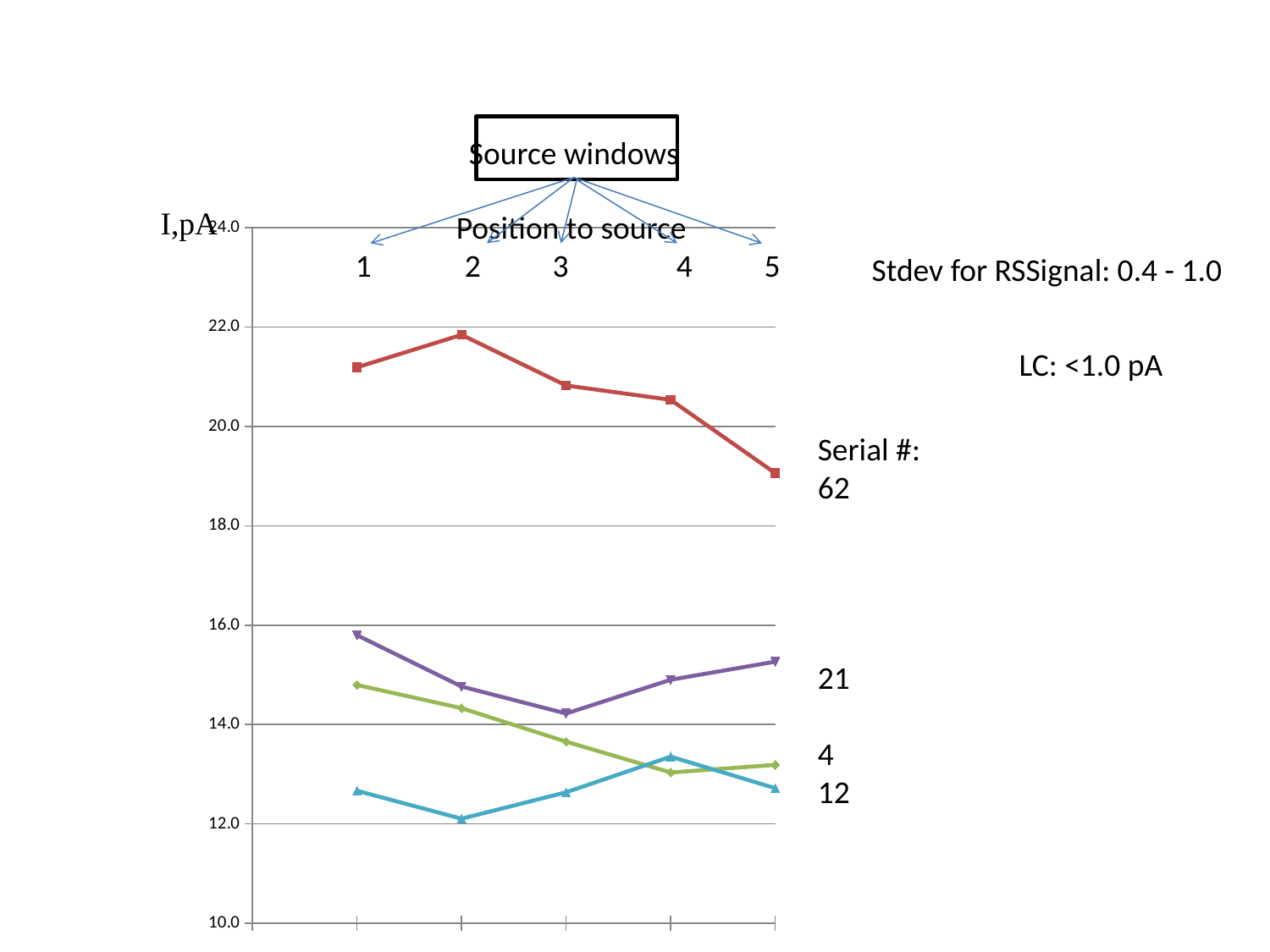
Is the value for serial # 21 at position 1 greater or less than 14.0? greater How many serial-number lines are plotted on the chart? 4 Is the value for serial # 12 at position 2 greater or less than 14.0? less Is the value for serial # 62 at position 2 greater or less than 20.0? greater Which serial # has the lowest value at position 2? 12 What kind of chart is shown on the slide? line chart Which serial # has the highest value at position 3? 62 Does the line for serial # 4 rise or fall from position 1 to position 4? fall How many positions to source are plotted along the x axis? 5 At position 1, which is larger: the value for serial # 62 or serial # 21? serial # 62 What is the label on the y axis of the chart? I,pA